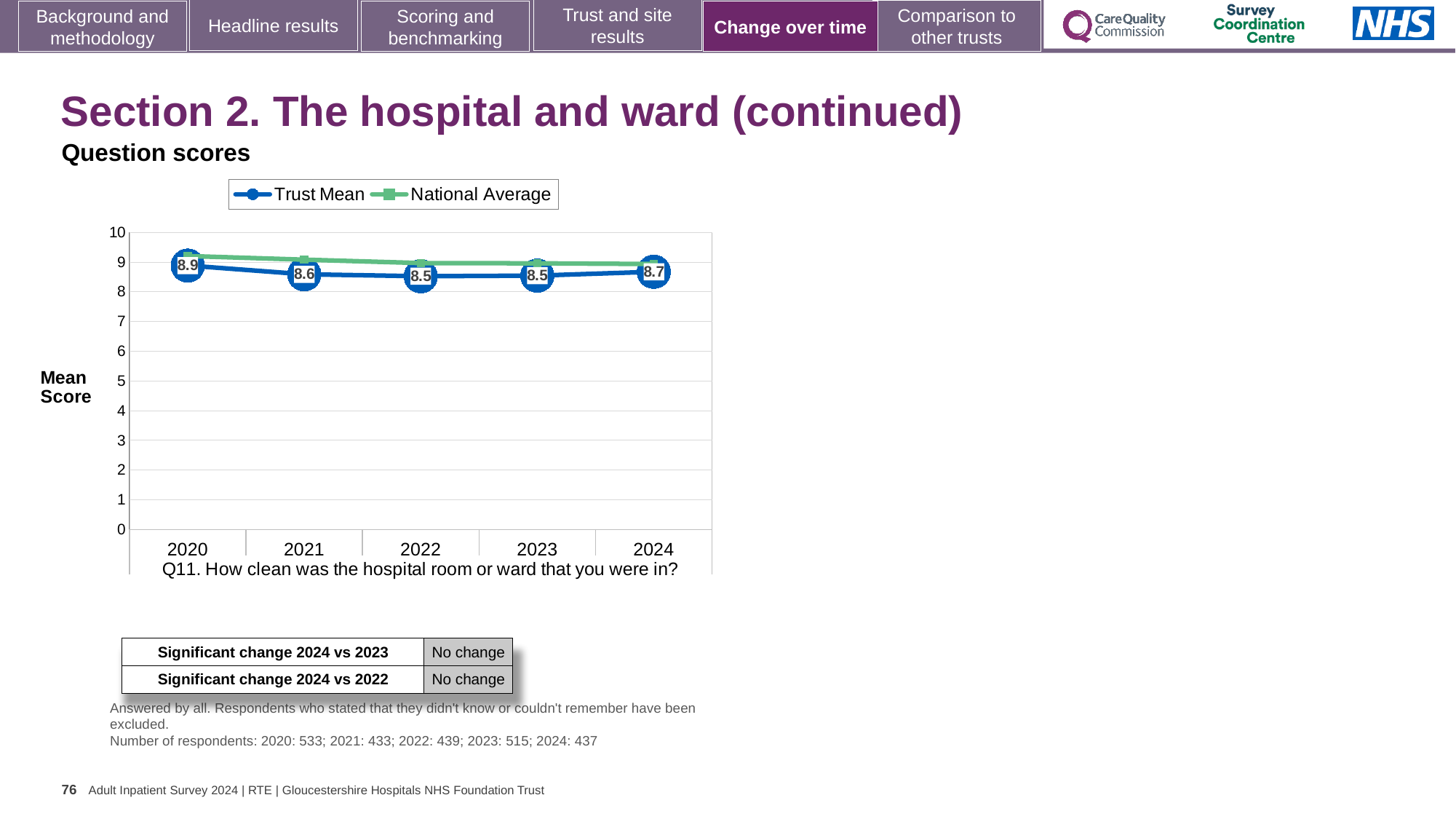
What is the Trust Mean value for 2020? 8.9 Which year has the larger Trust Mean, 2021 or 2024? 2024 Which survey question does the chart show scores for? Q11. How clean was the hospital room or ward that you were in? What is the difference between the Trust Mean in 2020 and in 2024? 0.2 What kind of chart is shown? Line chart Does the Trust Mean rise or fall from 2020 to 2022? Fall How many years are shown on the x axis? 5 What is the Trust Mean value for 2024? 8.7 What is the Trust Mean value for 2021? 8.6 How many series does the legend list? 2 In which year is the Trust Mean highest? 2020 Is the National Average value for 2020 greater or less than 9? greater